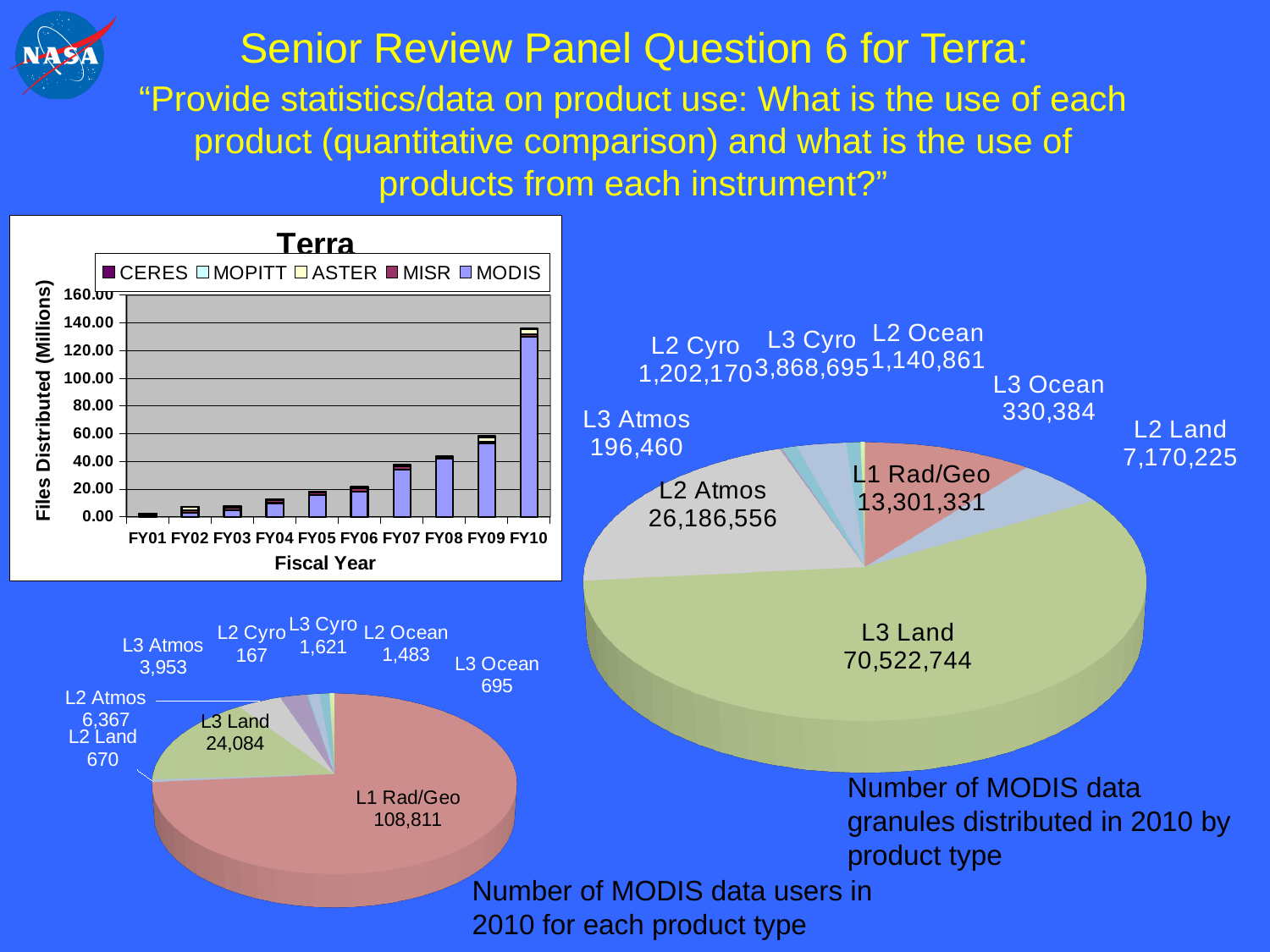
In the pie chart 'Number of MODIS data users in 2010 for each product type', which is larger, L2 Atmos or L3 Atmos? L2 Atmos In the 'Terra' bar chart, which fiscal year has the highest files distributed? FY10 In the 'Terra' bar chart, how many fiscal years are shown on the x axis? 10 What kind of chart is the 'Terra' chart at the top left of the slide? Stacked bar chart In the 'Terra' bar chart, is the total files distributed for FY10 greater or less than 120.00 million? greater In the pie chart 'Number of MODIS data users in 2010 for each product type', how many users are there for L1 Rad/Geo? 108,811 In the 'Terra' bar chart, do the files distributed generally rise or fall from FY01 to FY10? rise In the 'Terra' bar chart, how many series does the legend list? 5 In the pie chart 'Number of MODIS data granules distributed in 2010 by product type', how many granules were distributed for L3 Land? 70,522,744 In the 'Terra' bar chart, is the total files distributed for FY01 greater or less than 20.00 million? less In the pie chart 'Number of MODIS data granules distributed in 2010 by product type', which product type has the smallest number of granules? L3 Atmos In the pie chart 'Number of MODIS data granules distributed in 2010 by product type', what is the difference between L3 Land and L2 Atmos? 44,336,188